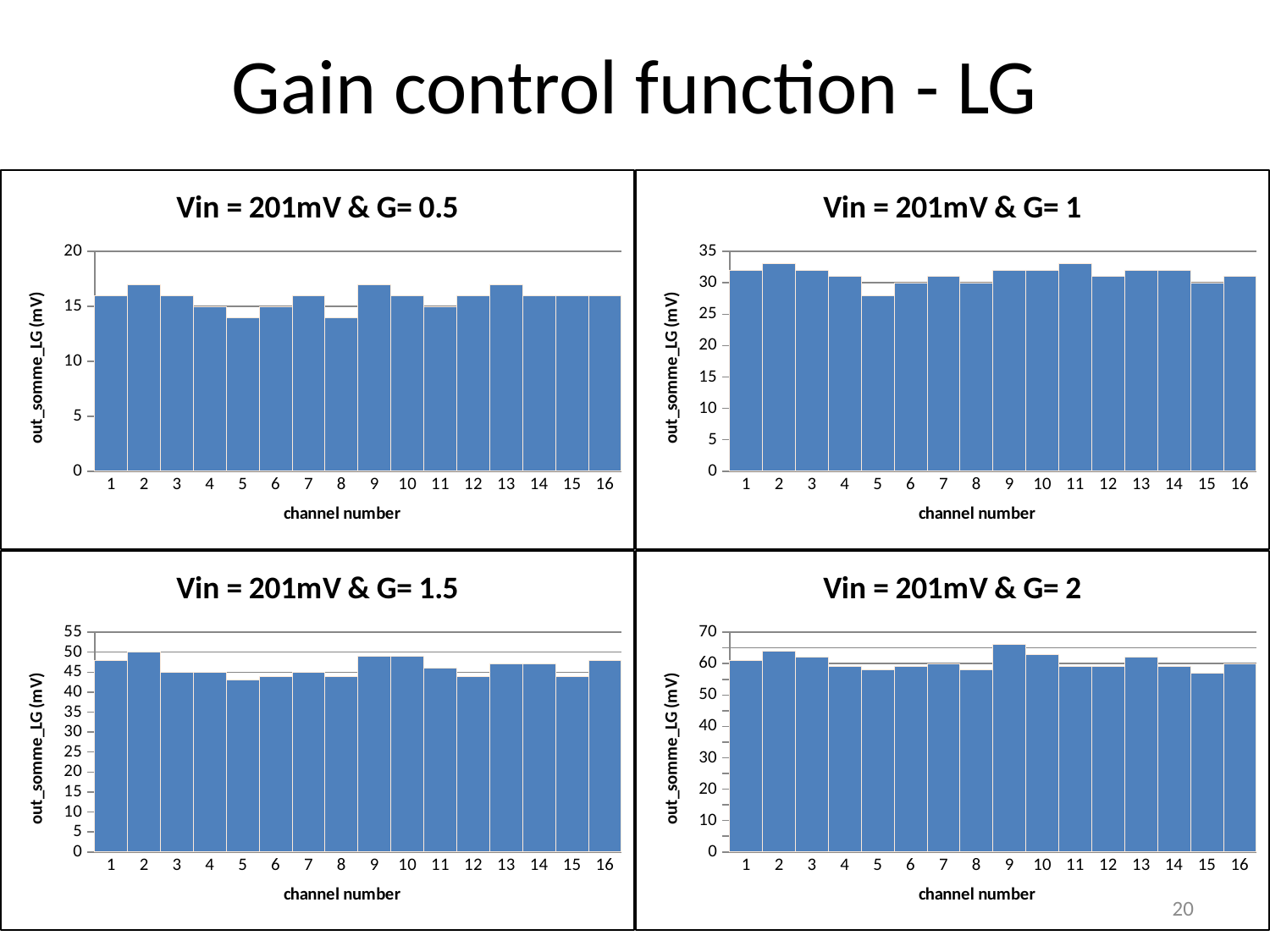
In the chart titled "Vin = 201mV & G= 1", which is larger, the value for channel 2 or the value for channel 5? channel 2 In the chart titled "Vin = 201mV & G= 0.5", is the value for channel 5 greater or less than 15? less In the chart titled "Vin = 201mV & G= 1", is the value for channel 2 greater or less than 30? greater How many channel numbers are shown on the x axis of the chart titled "Vin = 201mV & G= 0.5"? 16 What is the y-axis label of the chart titled "Vin = 201mV & G= 2"? out_somme_LG (mV) In the chart titled "Vin = 201mV & G= 1.5", which is larger, the value for channel 2 or the value for channel 5? channel 2 In the chart titled "Vin = 201mV & G= 2", is the value for channel 15 greater or less than 60? less In the chart titled "Vin = 201mV & G= 2", which channel number has the highest value? 9 What kind of chart is the chart titled "Vin = 201mV & G= 1.5"? bar chart In the chart titled "Vin = 201mV & G= 1", which channel number has the lowest value? 5